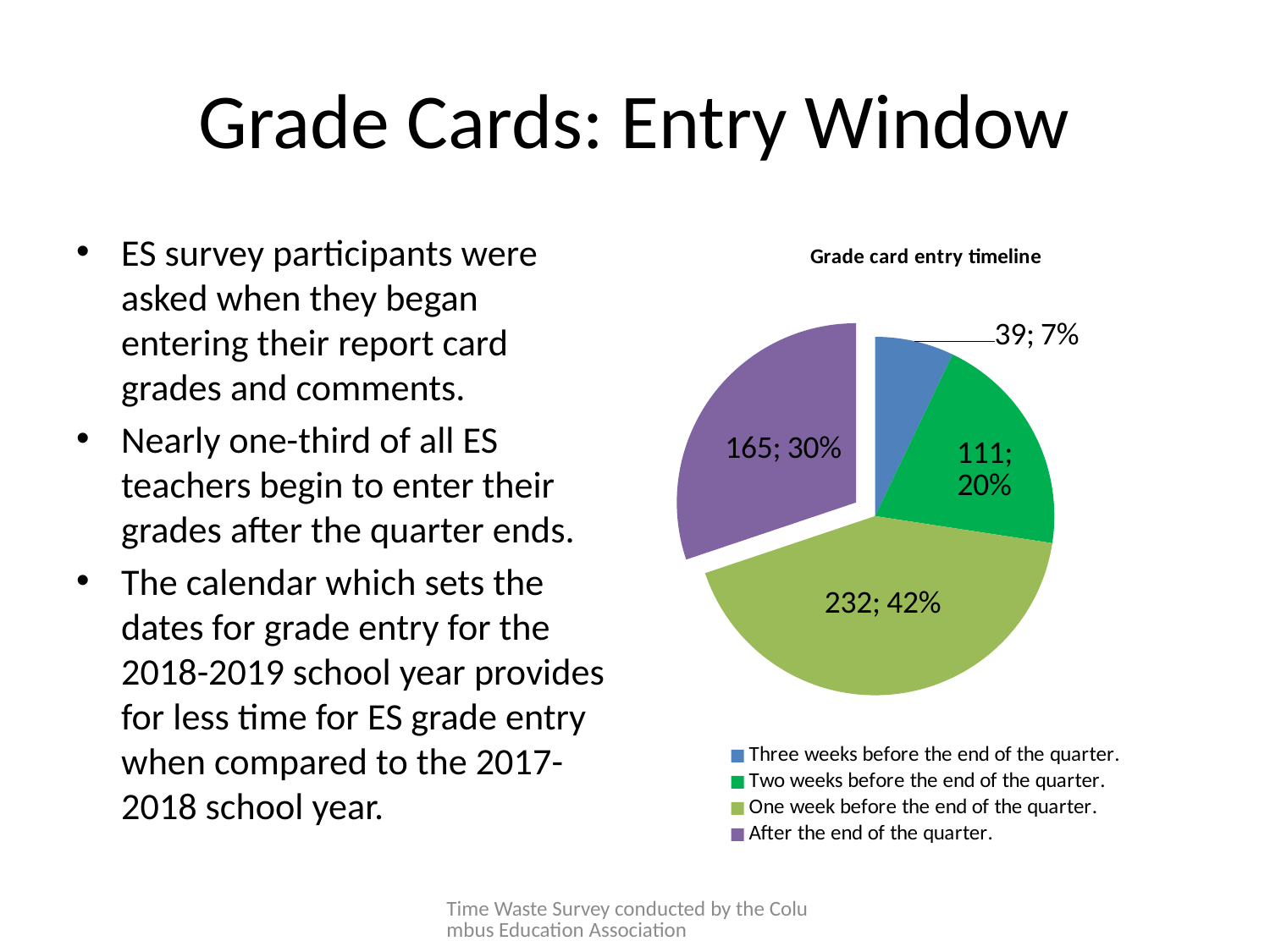
How many slices does the pie chart have? 4 What percentage share is shown for 'After the end of the quarter.'? 30% What is the count for 'One week before the end of the quarter.'? 232 What kind of chart is shown on the slide? pie chart Which category has the largest slice? One week before the end of the quarter. What is the difference in count between 'One week before the end of the quarter.' and 'After the end of the quarter.'? 67 How many entries does the legend list? 4 What percentage share is shown for 'Two weeks before the end of the quarter.'? 20% What is the title of the chart? Grade card entry timeline Which category has the smallest slice? Three weeks before the end of the quarter. What is the count for 'Three weeks before the end of the quarter.'? 39 Which is larger, the count for 'Two weeks before the end of the quarter.' or 'After the end of the quarter.'? After the end of the quarter.